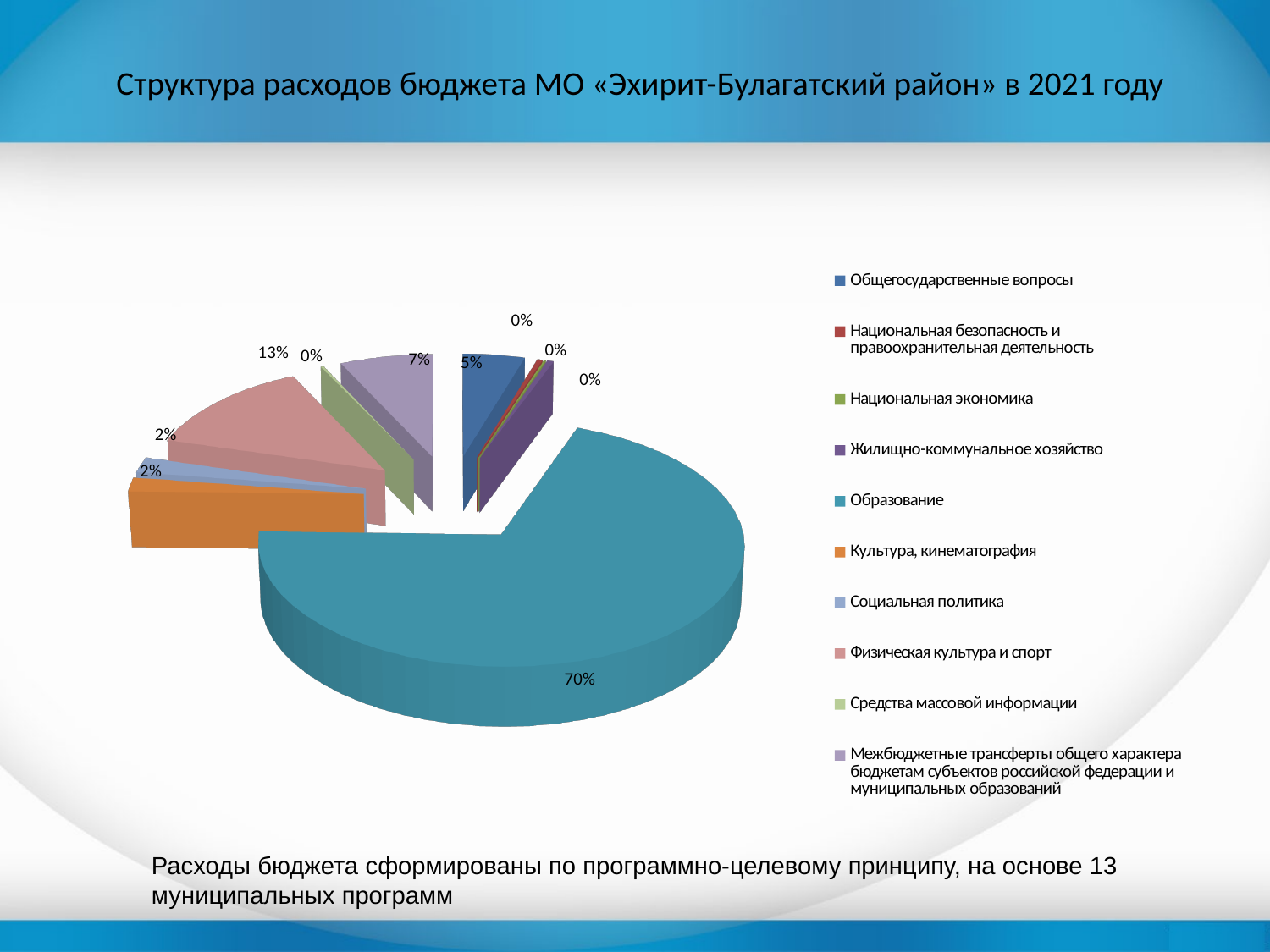
Which category has the largest share of the budget expenditure? Образование How many categories does the legend list? 10 What kind of chart is shown on the slide? pie chart What share of the budget expenditure goes to Физическая культура и спорт? 13% What share of the budget expenditure goes to Межбюджетные трансферты общего характера бюджетам субъектов российской федерации и муниципальных образований? 7% What is the title of the slide containing the chart? Структура расходов бюджета МО «Эхирит-Булагатский район» в 2021 году What share of the budget expenditure goes to Социальная политика? 2% Which has a larger share: Физическая культура и спорт or Общегосударственные вопросы? Физическая культура и спорт What is the difference in percentage points between the share for Образование and the share for Физическая культура и спорт? 57 percentage points